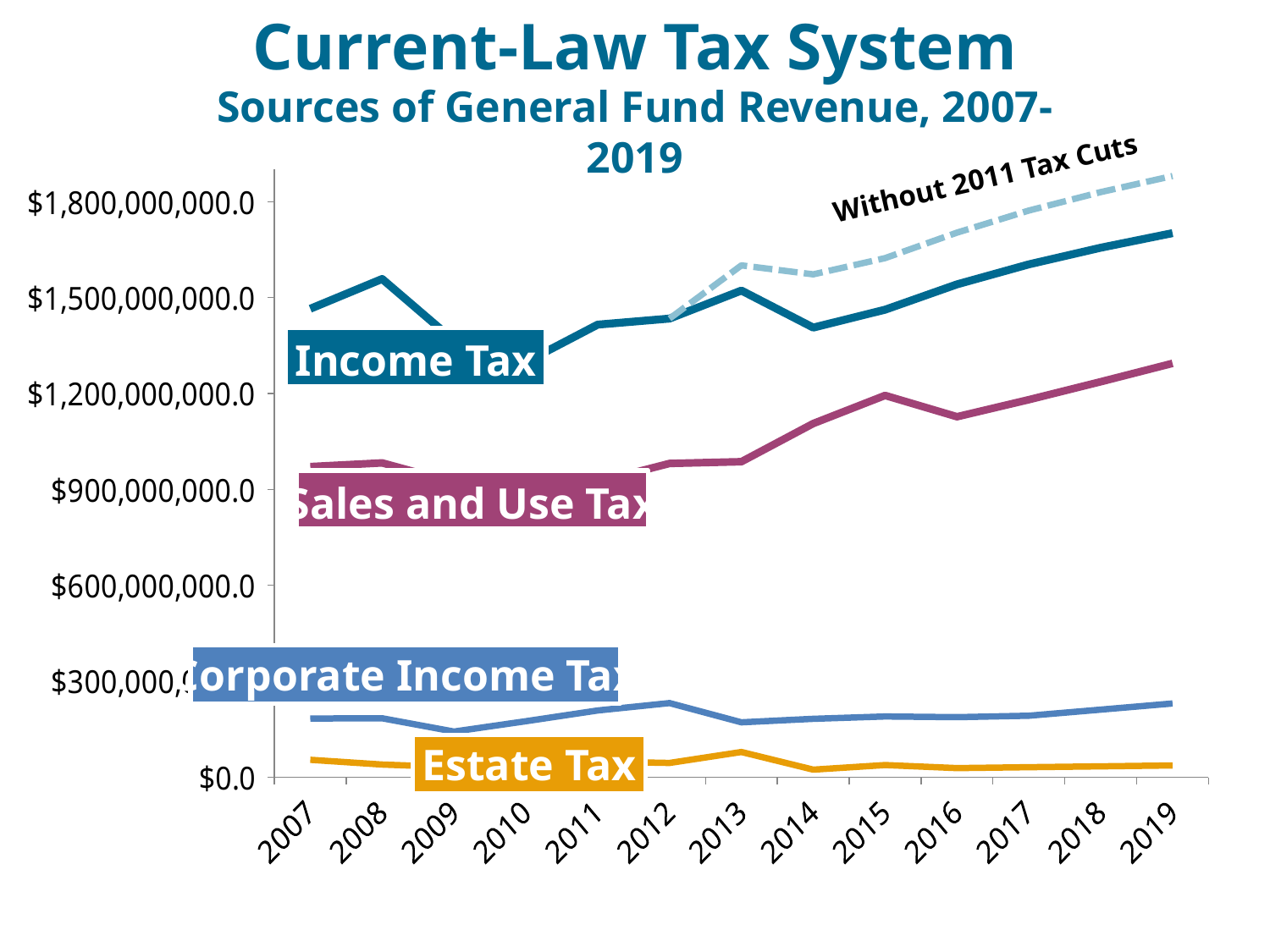
What is the main title of the chart? Current-Law Tax System What kind of chart is shown on the slide? line chart Which tax source has the lowest revenue across the years shown? Estate Tax In 2019, which is larger: the Income Tax line or the Without 2011 Tax Cuts line? Without 2011 Tax Cuts Is the Income Tax value for 2014 greater or less than $1,500,000,000.0? less What does the dashed line on the chart represent? Without 2011 Tax Cuts Is the Income Tax value for 2019 greater or less than $1,500,000,000.0? greater Is the Sales and Use Tax value for 2019 greater or less than $1,200,000,000.0? greater How many tax sources are labeled on the chart? 4 Which tax source has the highest revenue in 2019? Income Tax How many years are shown along the x axis? 13